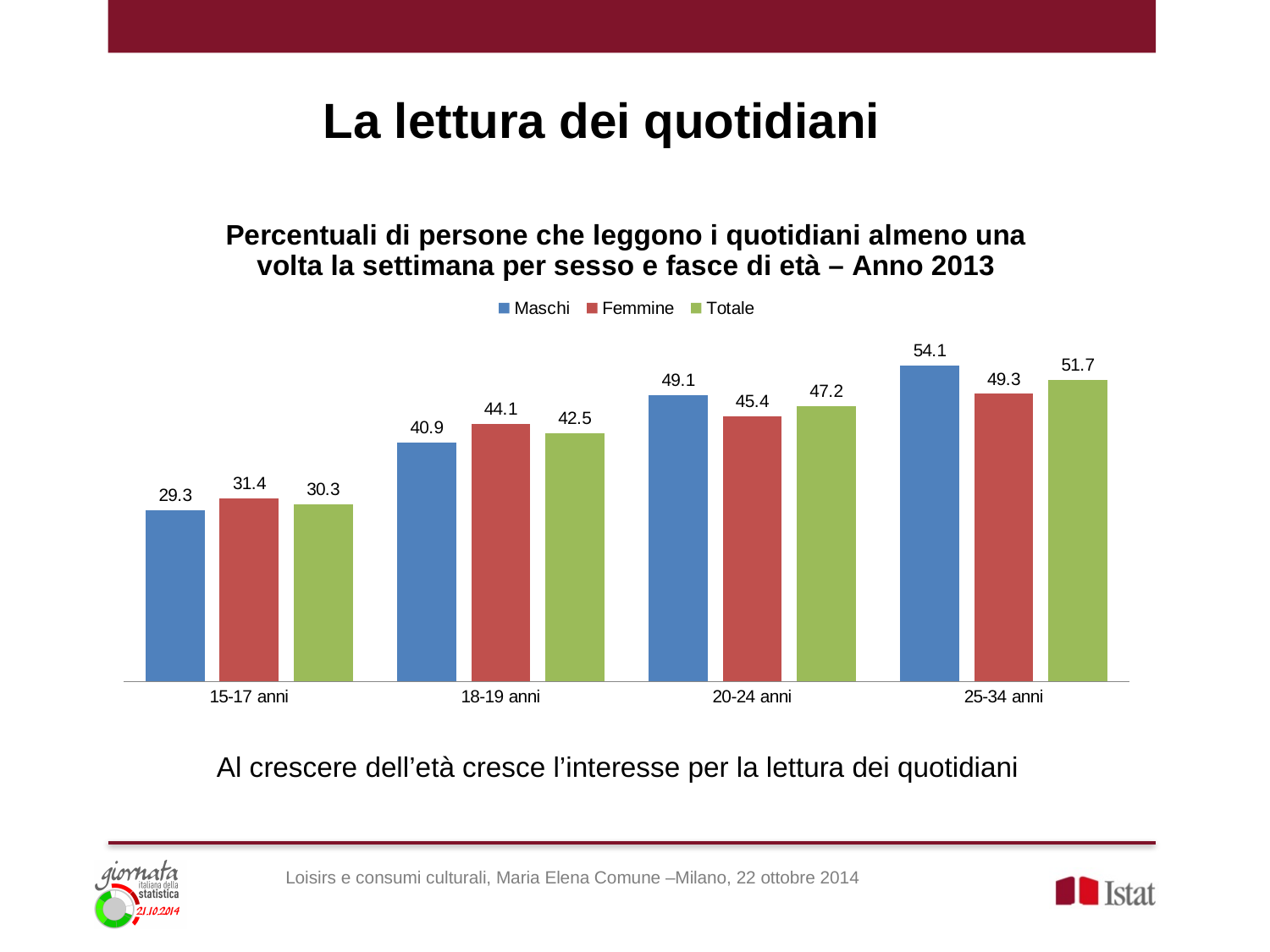
Do the Totale values rise or fall as age increases along the x axis? Rise In the 15-17 anni age group, which is larger, Maschi or Femmine? Femmine What kind of chart is shown on the slide? Bar chart What is the value for Femmine in the 18-19 anni age group? 44.1 How many age groups are shown on the x axis? 4 What is the value for Maschi in the 15-17 anni age group? 29.3 Which age group has the lowest value for Totale? 15-17 anni Which age group has the highest value for Maschi? 25-34 anni Which colour represents the Femmine series in the chart? Red What is the difference between the Maschi and Femmine values in the 25-34 anni age group? 4.8 How many series does the legend list? 3 What is the value for Totale in the 20-24 anni age group? 47.2